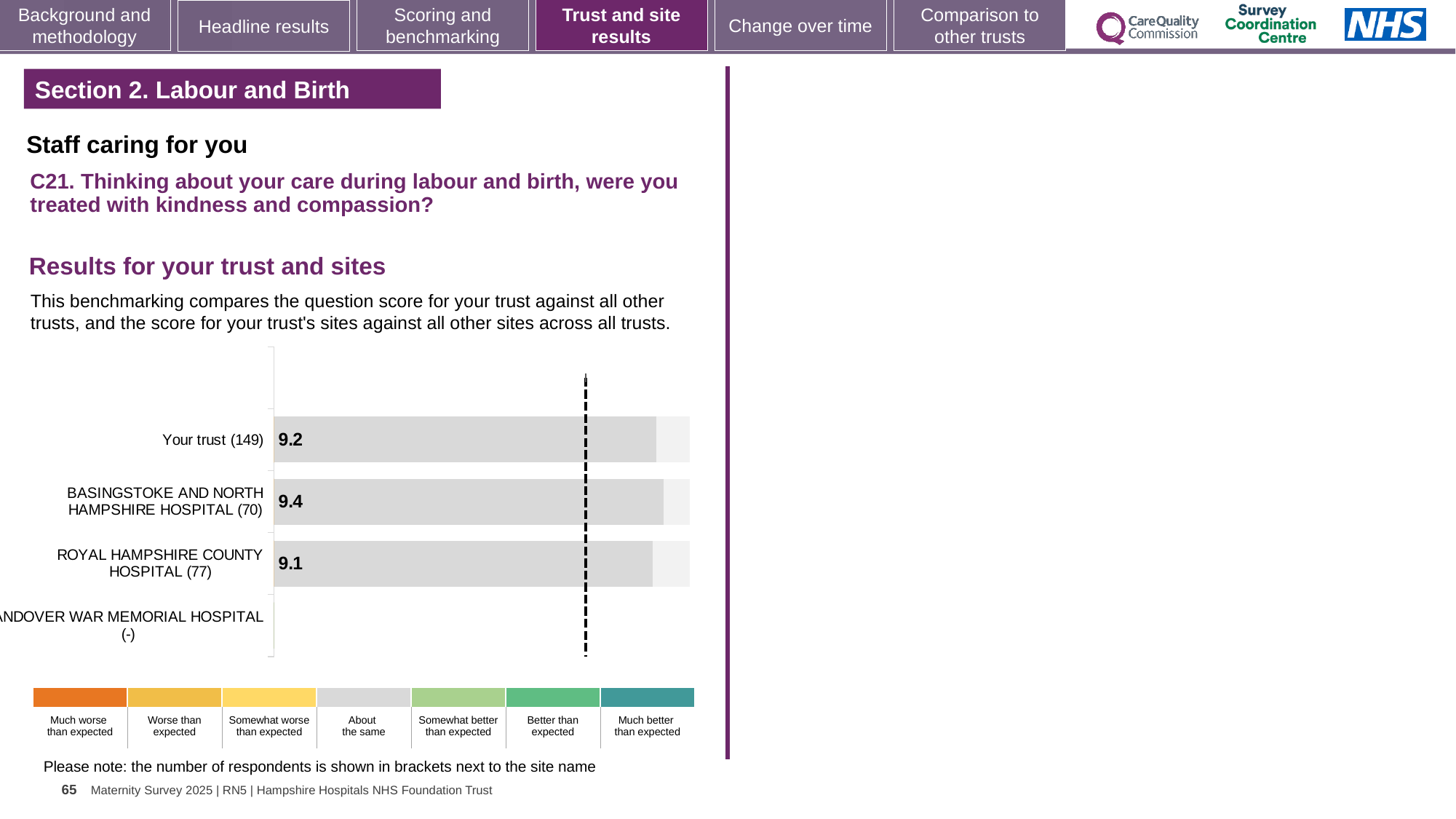
Which site on the chart has no score shown, with '(-)' next to its name? Andover War Memorial Hospital How many rows (trust and sites) are listed on the chart? 4 What is the difference between the scores for Basingstoke and North Hampshire Hospital and Your trust? 0.2 How many respondents are shown in brackets for Your trust? 149 What type of chart is shown on the slide? Bar chart What is the score for Royal Hampshire County Hospital (77)? 9.1 What is the score for Your trust (149)? 9.2 Which site or trust has the highest score on the chart? Basingstoke and North Hampshire Hospital (70) What is the difference between the scores for Basingstoke and North Hampshire Hospital and Royal Hampshire County Hospital? 0.3 Among the rows with a plotted score, which has the lowest score? Royal Hampshire County Hospital (77) Which has a higher score, Your trust or Royal Hampshire County Hospital? Your trust What is the score for Basingstoke and North Hampshire Hospital (70)? 9.4